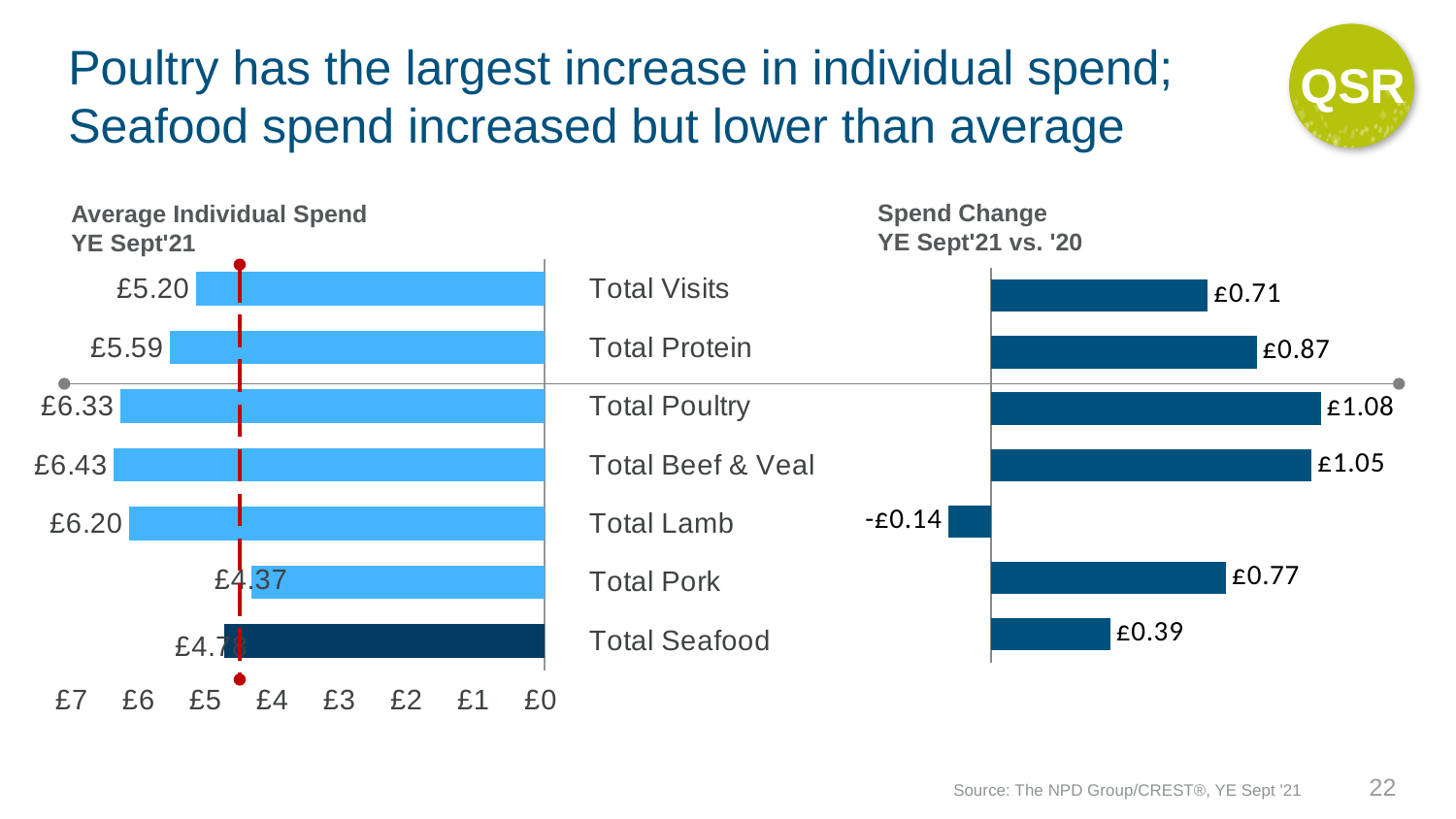
On the Average Individual Spend YE Sept'21 chart, what is the value for Total Beef & Veal? £6.43 On the Spend Change YE Sept'21 vs. '20 chart, what is the value for Total Poultry? £1.08 On the Spend Change YE Sept'21 vs. '20 chart, which category has the lowest value? Total Lamb On the Spend Change YE Sept'21 vs. '20 chart, which category has the highest value? Total Poultry On the Spend Change YE Sept'21 vs. '20 chart, what is the value for Total Lamb? -£0.14 How many categories are shown on the Spend Change YE Sept'21 vs. '20 chart? 7 On the Average Individual Spend YE Sept'21 chart, what is the difference between Total Beef & Veal and Total Pork? £2.06 On the Spend Change YE Sept'21 vs. '20 chart, what is the difference between Total Poultry and Total Beef & Veal? £0.03 What kind of chart is the Average Individual Spend YE Sept'21 chart? bar chart On the Average Individual Spend YE Sept'21 chart, which category has the lowest value? Total Pork On the Average Individual Spend YE Sept'21 chart, is the value for Total Pork greater or less than £5? less On the Average Individual Spend YE Sept'21 chart, which is larger, Total Protein or Total Visits? Total Protein